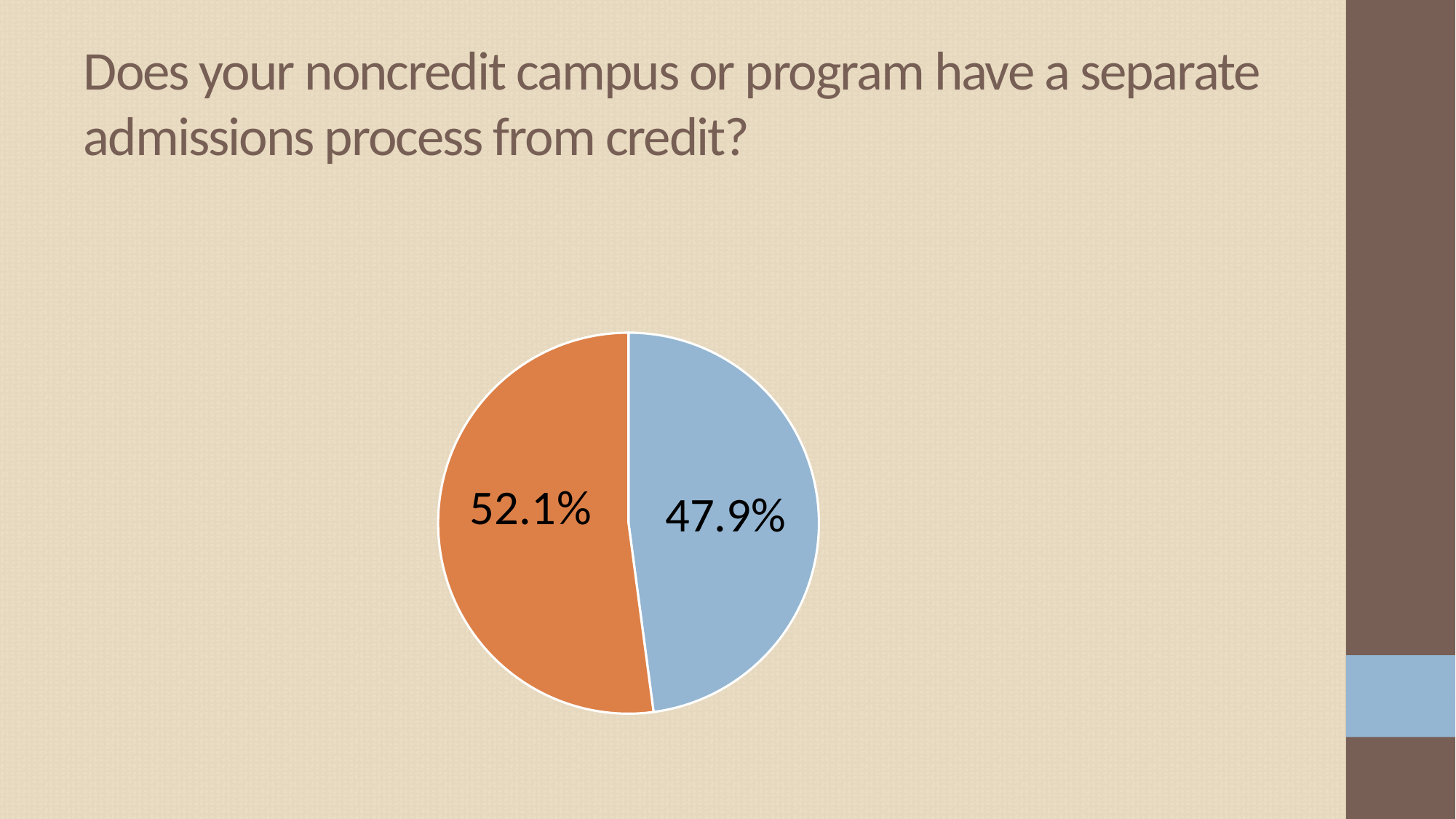
What do the two slices of the pie chart add up to? 100% What percentage is shown on the blue slice of the pie chart? 47.9% Which slice of the pie chart is the smallest? the blue slice (47.9%) How many slices does the pie chart have? 2 Which slice of the pie chart is the largest? the orange slice (52.1%) What question does the slide title ask? Does your noncredit campus or program have a separate admissions process from credit? What percentage is shown on the orange slice of the pie chart? 52.1% Is the share of the orange slice greater or less than 50%? greater Which is larger, the orange slice or the blue slice? the orange slice What is the difference in percentage points between the orange slice and the blue slice? 4.2 percentage points Is the share of the blue slice greater or less than 50%? less What kind of chart is shown on the slide? pie chart